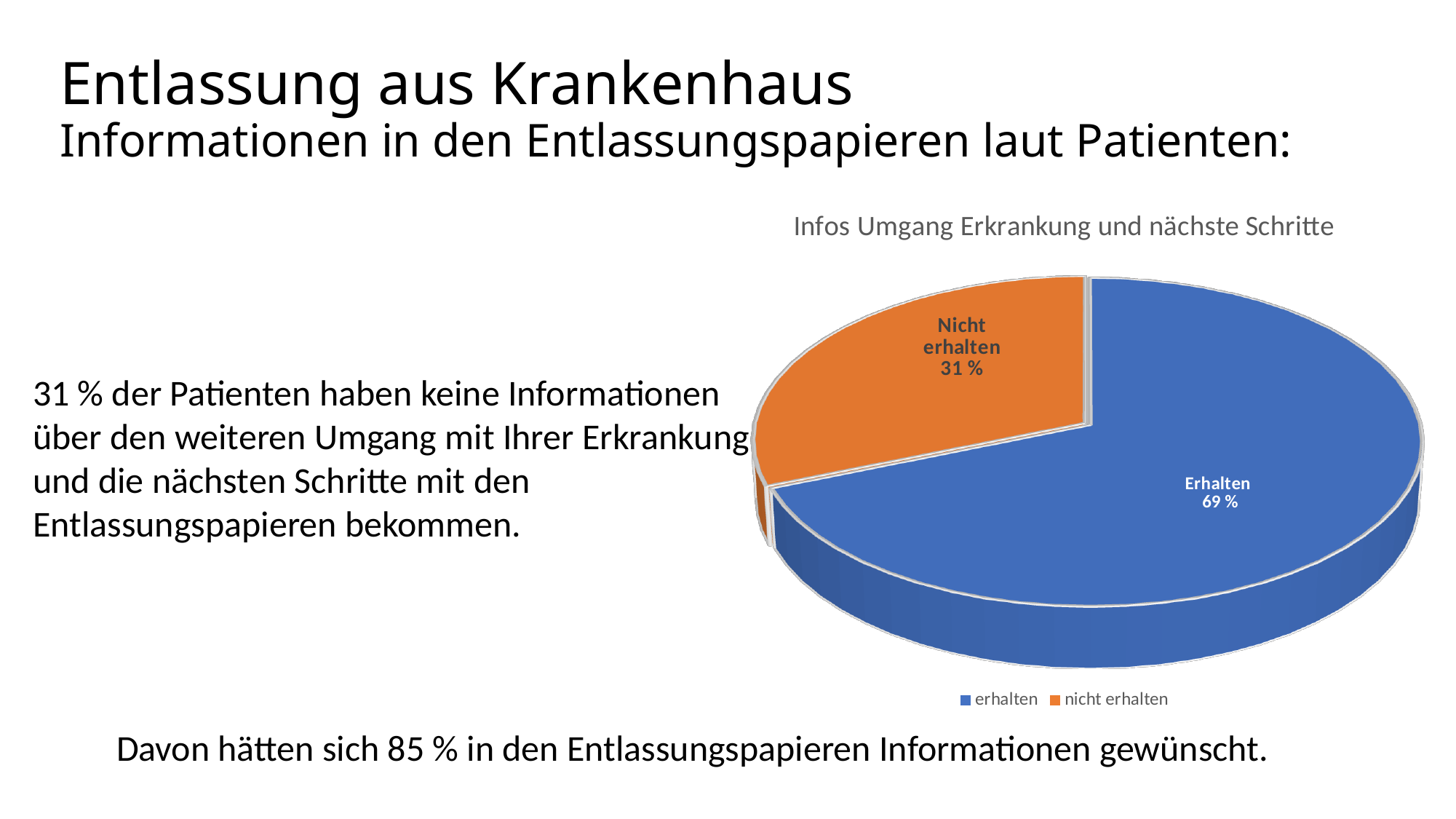
Which is larger, the "Erhalten" slice or the "Nicht erhalten" slice? Erhalten Which slice of the pie is the smallest? Nicht erhalten What share of the pie is labelled "Nicht erhalten"? 31 % How many slices does the pie chart have? 2 What kind of chart is shown on the slide? Pie chart Which slice of the pie is the largest? Erhalten What is the title of the chart? Infos Umgang Erkrankung und nächste Schritte What colour is the "nicht erhalten" slice? Orange What is the total of the two slices shown in the pie chart? 100 % What share of the pie is labelled "Erhalten"? 69 % How many entries does the legend list? 2 What is the difference in percentage points between the "Erhalten" and "Nicht erhalten" slices? 38